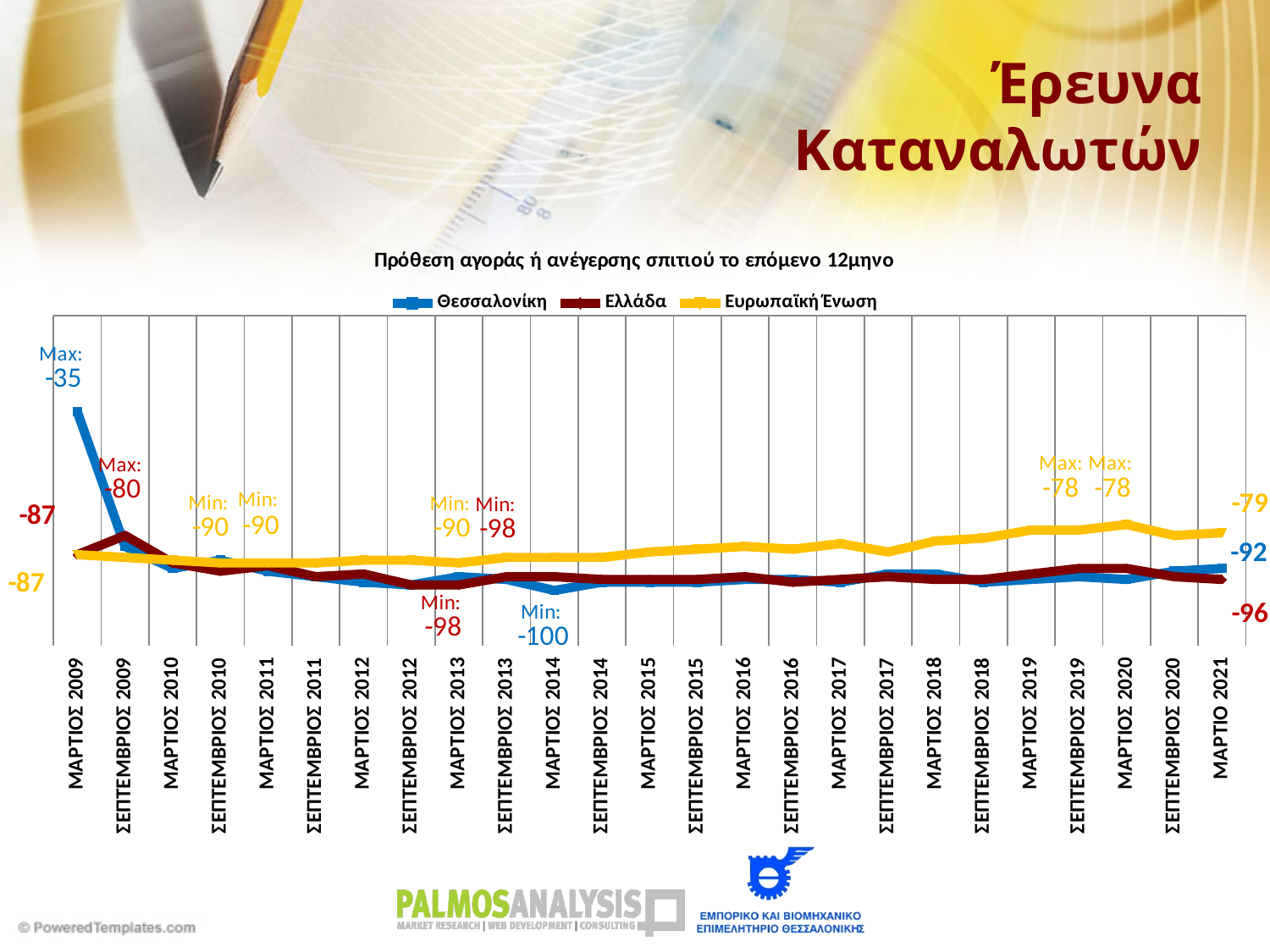
What is the value for Θεσσαλονίκη in ΜΑΡΤΙΟΣ 2009? -35 How many series does the legend list? 3 What is the maximum value reached by the Ελλάδα series? -80 What is the minimum value reached by the Θεσσαλονίκη series? -100 How many time points are shown on the x axis? 25 What is the value for Ελλάδα in ΜΑΡΤΙΟ 2021? -96 In ΜΑΡΤΙΟ 2021, what is the difference between the Ευρωπαϊκή Ένωση value and the Ελλάδα value? 17 What is the value for Ευρωπαϊκή Ένωση in ΜΑΡΤΙΟ 2021? -79 What kind of chart is shown on the slide? line chart What is the value for Θεσσαλονίκη in ΜΑΡΤΙΟ 2021? -92 In ΜΑΡΤΙΟ 2021, which is higher: Θεσσαλονίκη or Ελλάδα? Θεσσαλονίκη